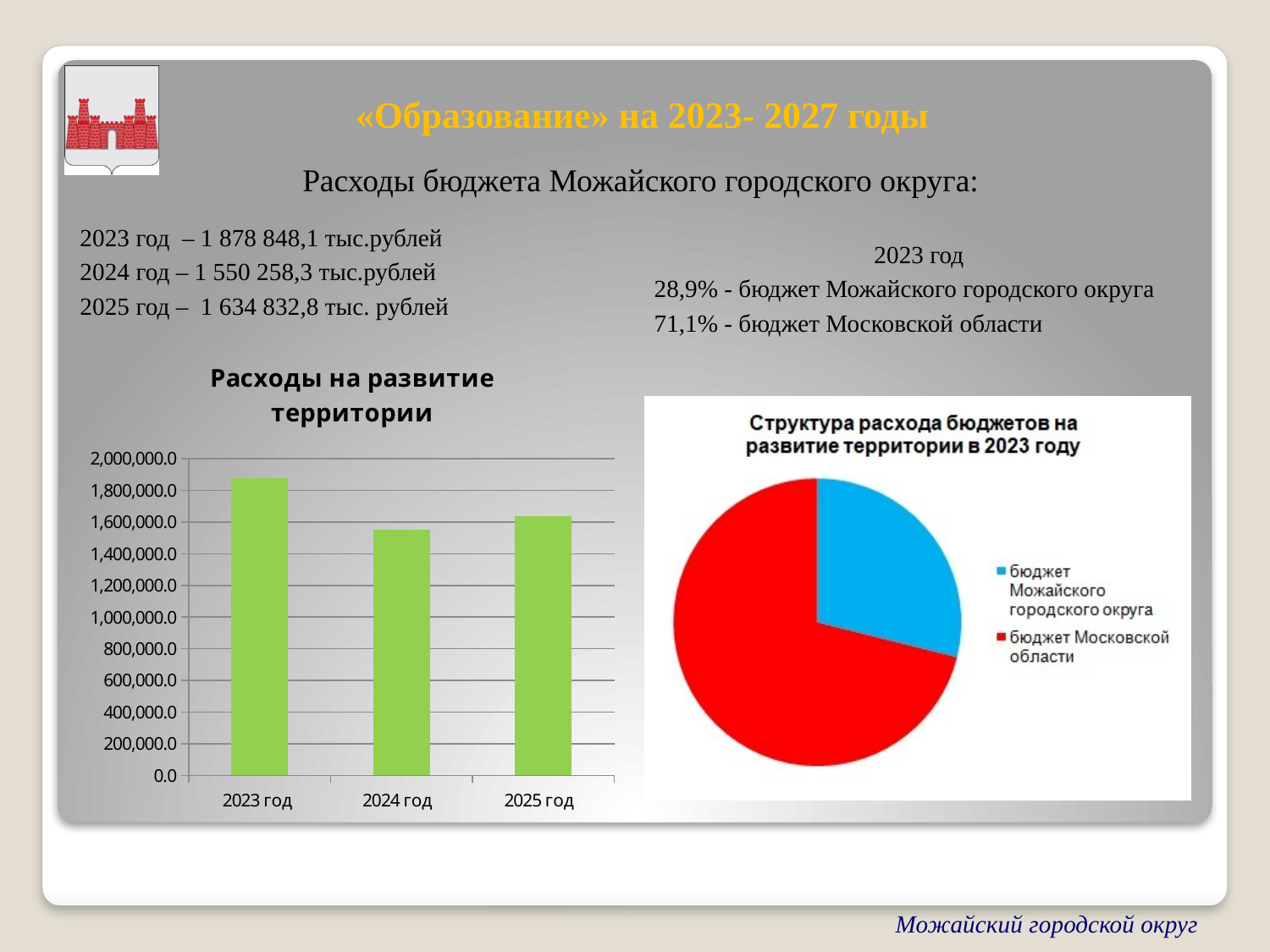
In the pie chart «Структура расхода бюджетов на развитие территории в 2023 году», what colour is the slice for «бюджет Московской области»? red In the pie chart «Структура расхода бюджетов на развитие территории в 2023 году», what share does «бюджет Можайского городского округа» have? 28,9% In the pie chart «Структура расхода бюджетов на развитие территории в 2023 году», what share does «бюджет Московской области» have? 71,1% What kind of chart is the chart titled «Расходы на развитие территории»? bar chart In the bar chart «Расходы на развитие территории», which bar is taller: 2024 год or 2025 год? 2025 год In the bar chart «Расходы на развитие территории», is the value for 2025 год greater or less than 1,600,000.0? greater In the bar chart «Расходы на развитие территории», which year has the highest bar? 2023 год In the bar chart «Расходы на развитие территории», which year has the lowest bar? 2024 год In the bar chart «Расходы на развитие территории», is the value for 2024 год greater or less than 1,600,000.0? less In the bar chart «Расходы на развитие территории», is the value for 2023 год greater or less than 1,800,000.0? greater In the bar chart «Расходы на развитие территории», how many years are shown on the x axis? 3 What kind of chart is the chart titled «Структура расхода бюджетов на развитие территории в 2023 году»? pie chart